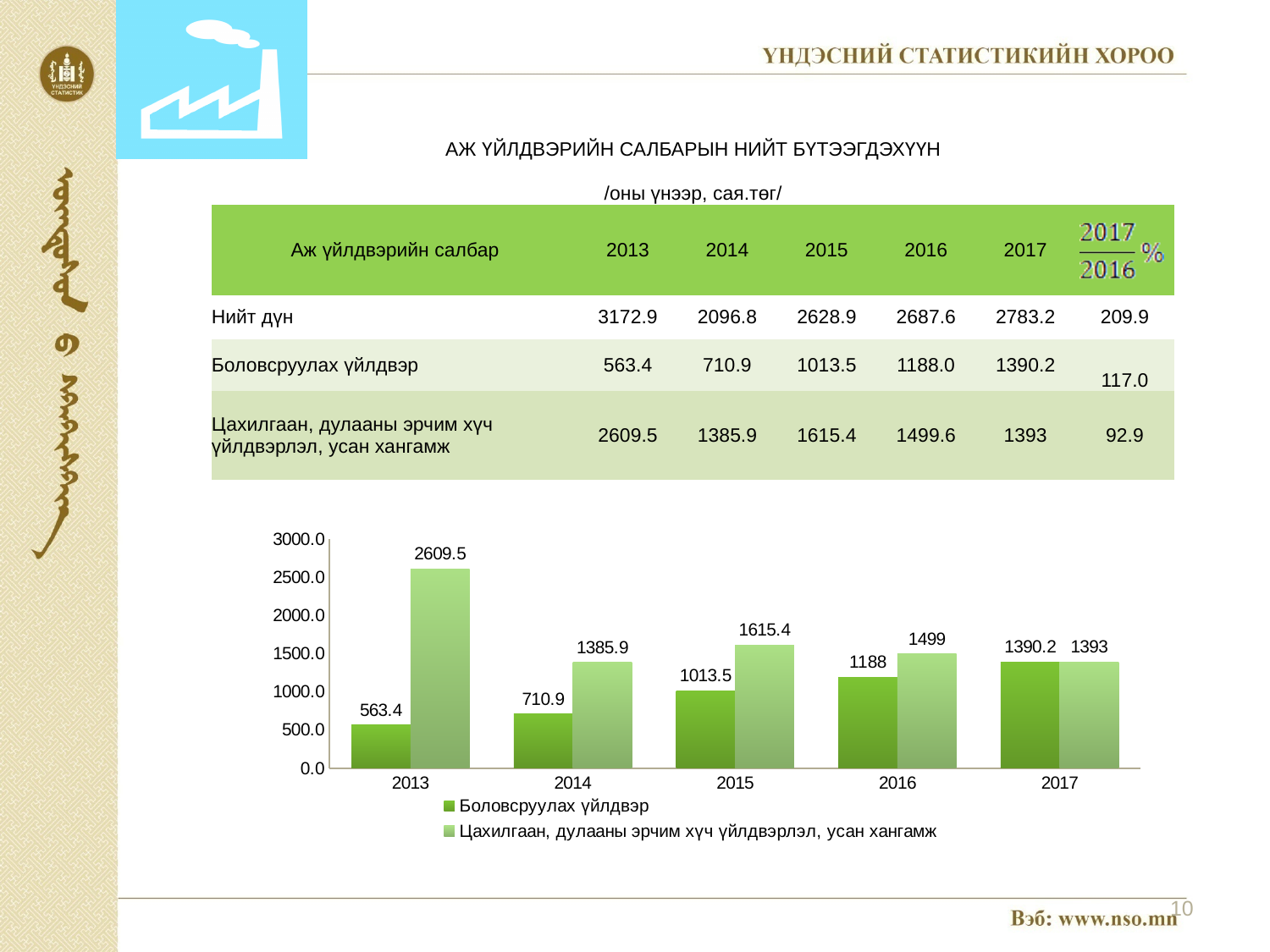
What is the value for Боловсруулах үйлдвэр in 2013? 563.4 How many years are shown on the x axis of the chart? 5 Which series has the larger value in 2014? Цахилгаан, дулааны эрчим хүч үйлдвэрлэл, усан хангамж Does the value for Боловсруулах үйлдвэр rise or fall from 2013 to 2017? rise What is the value for Боловсруулах үйлдвэр in 2017? 1390.2 What is the value for Цахилгаан, дулааны эрчим хүч үйлдвэрлэл, усан хангамж in 2015? 1615.4 What is the difference between the two series' values in 2013? 2046.1 In which year is the value for Цахилгаан, дулааны эрчим хүч үйлдвэрлэл, усан хангамж highest? 2013 What type of chart is shown on the slide? bar chart In which year is the value for Боловсруулах үйлдвэр lowest? 2013 Which colour represents Боловсруулах үйлдвэр in the chart? dark green How many series does the chart legend list? 2